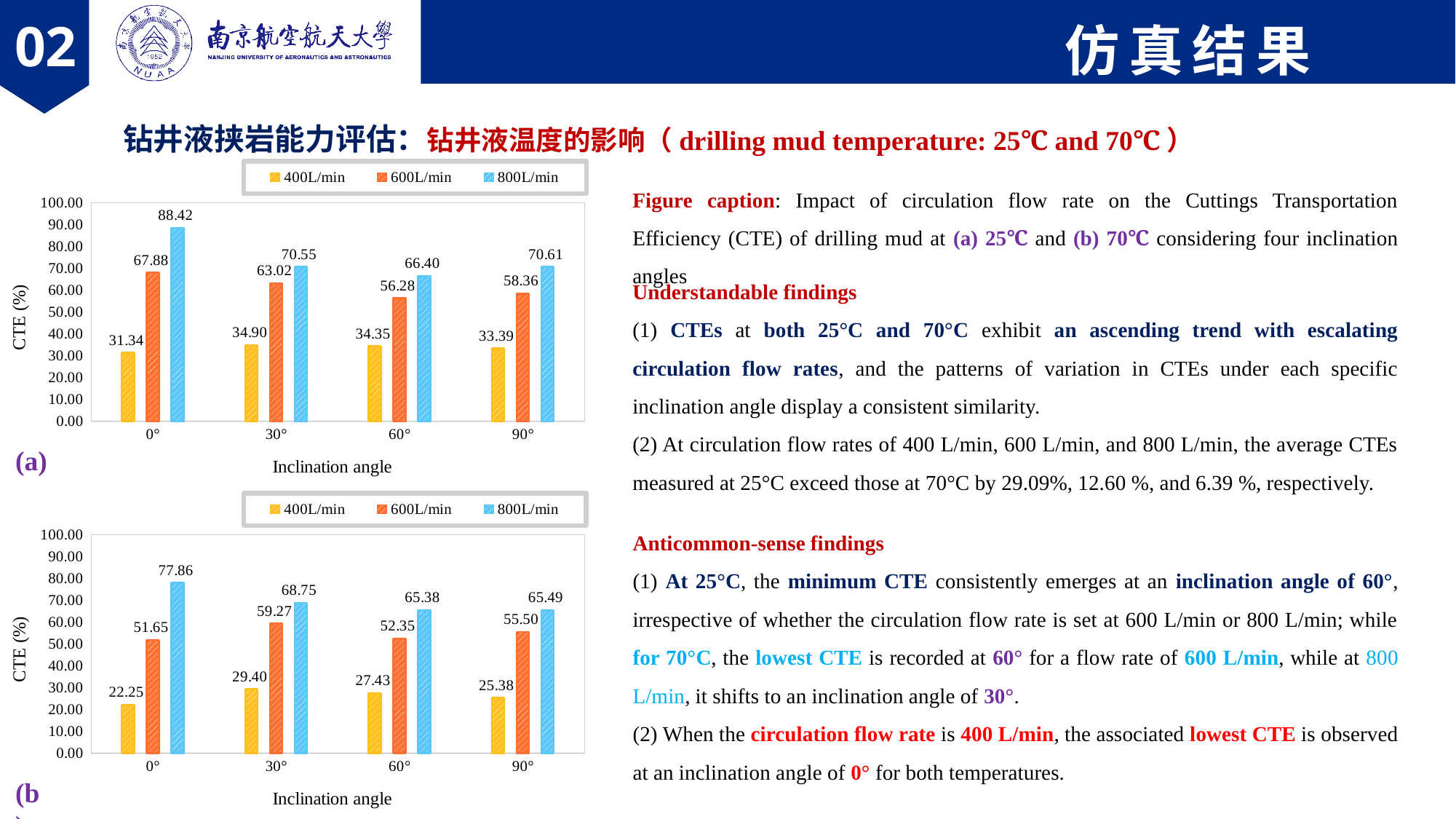
In the top chart (a), which inclination angle has the lowest CTE for the 400L/min series? 0° In the bottom chart (b), what is the CTE for 600L/min at an inclination angle of 30°? 59.27 In the bottom chart (b), what is the difference between the 400L/min CTE at 30° and at 0°? 7.15 In the top chart (a), is the CTE for 600L/min at 90° greater or less than 50.00? greater How many series does the legend of the top chart (a) list? 3 In the top chart (a), what is the difference between the 800L/min and 600L/min CTE values at 60°? 10.12 What is the y-axis label of the top chart (a)? CTE (%) In the bottom chart (b), which is larger: the 600L/min CTE at 0° or the 600L/min CTE at 90°? 600L/min at 90° In the top chart (a), what is the CTE for 800L/min at an inclination angle of 0°? 88.42 How many inclination angle categories are shown on the x axis of the bottom chart (b)? 4 In the bottom chart (b), which inclination angle has the highest CTE for the 800L/min series? 0° What type of chart is the bottom chart (b)? Bar chart